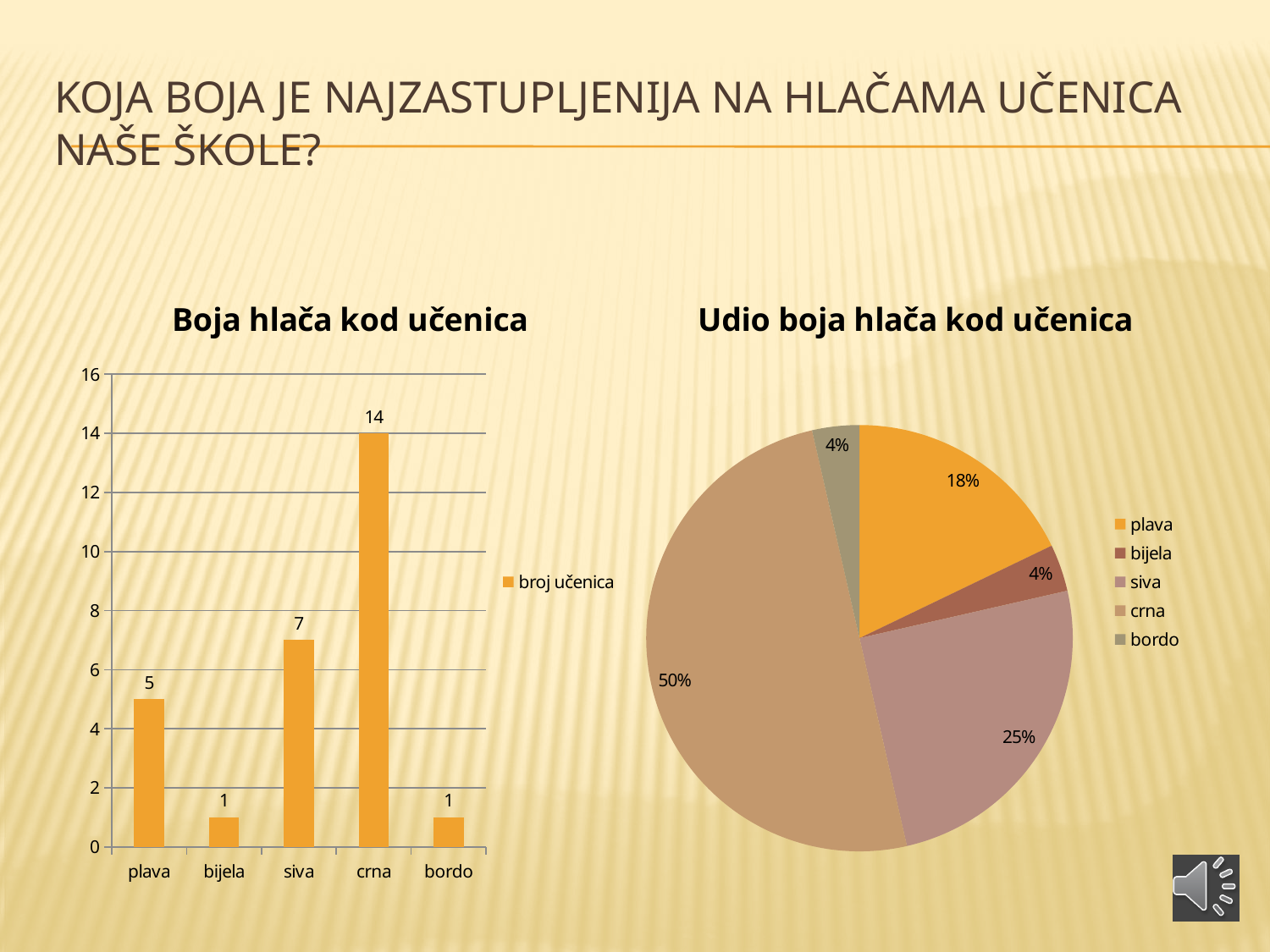
In the 'Boja hlača kod učenica' bar chart, what is the value for siva? 7 What kind of chart is 'Boja hlača kod učenica'? bar chart In the 'Udio boja hlača kod učenica' pie chart, what share does plava have? 18% In the 'Boja hlača kod učenica' bar chart, what is the value for crna? 14 In the 'Boja hlača kod učenica' bar chart, which is larger, the value for plava or the value for siva? siva In the 'Boja hlača kod učenica' bar chart, what is the difference between the values for crna and plava? 9 In the 'Boja hlača kod učenica' bar chart, what series does the legend list? broj učenica In the 'Boja hlača kod učenica' bar chart, how many categories are shown on the x axis? 5 In the 'Boja hlača kod učenica' bar chart, which category has the highest value? crna In the 'Udio boja hlača kod učenica' pie chart, which slice is the largest? crna In the 'Udio boja hlača kod učenica' pie chart, what share does crna have? 50% What kind of chart is 'Udio boja hlača kod učenica'? pie chart